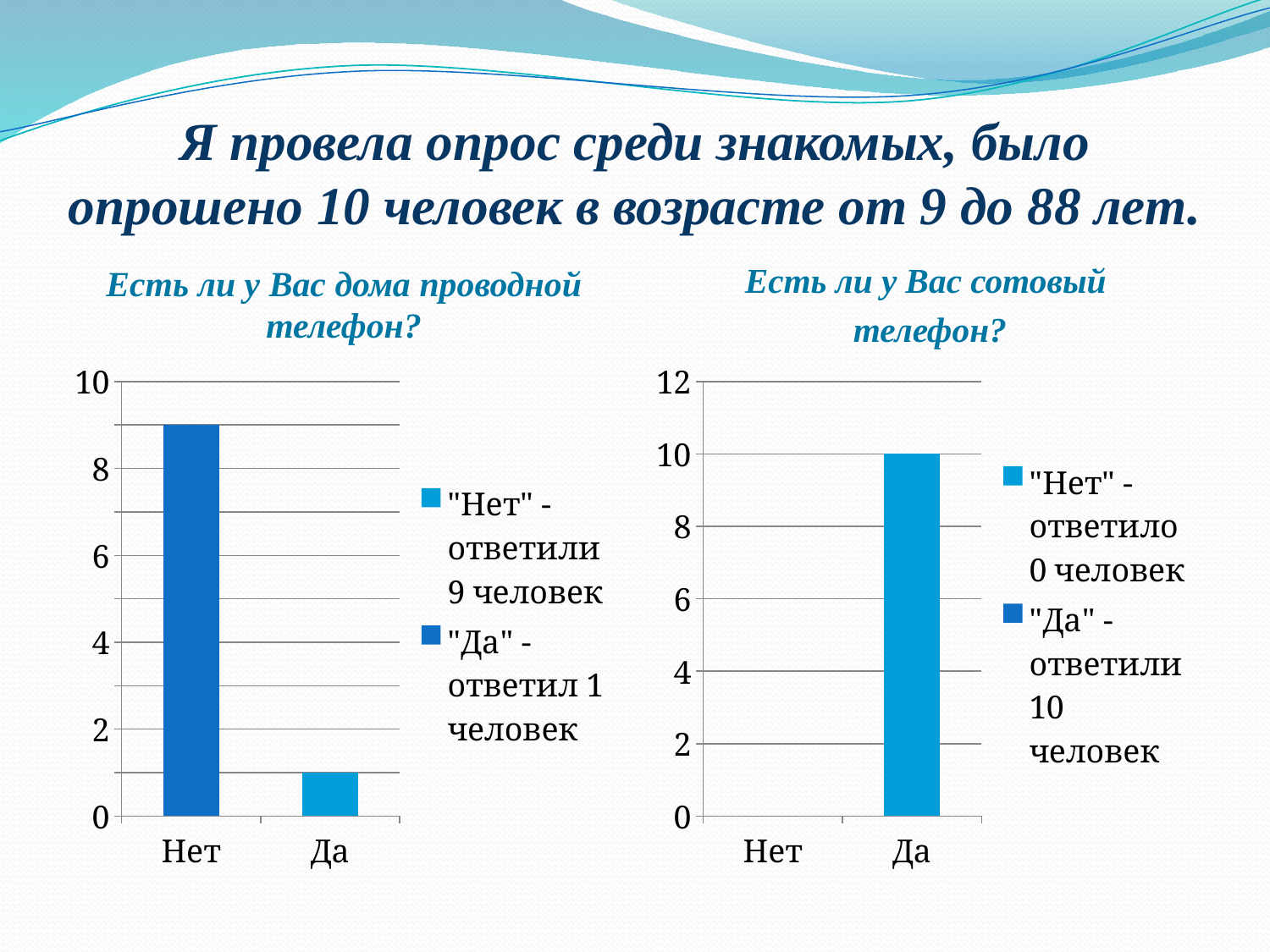
How many categories are shown on the x axis of the right chart? 2 In the chart titled "Есть ли у Вас дома проводной телефон?", how many people answered "Нет"? 9 In the left chart, is the value for "Нет" greater or less than 6? greater In the right chart, which is larger, the value for "Да" or the value for "Нет"? Да How many entries does the legend of the left chart list? 2 What type of chart is the chart titled "Есть ли у Вас сотовый телефон?"? bar chart In the chart titled "Есть ли у Вас сотовый телефон?", how many people answered "Да"? 10 In the chart titled "Есть ли у Вас дома проводной телефон?", how many people answered "Да"? 1 In the left chart, which answer has the highest value? Нет In the left chart, what is the difference between the "Нет" and "Да" values? 8 In the chart titled "Есть ли у Вас сотовый телефон?", how many people answered "Нет"? 0 In the right chart, which answer has the lowest value? Нет